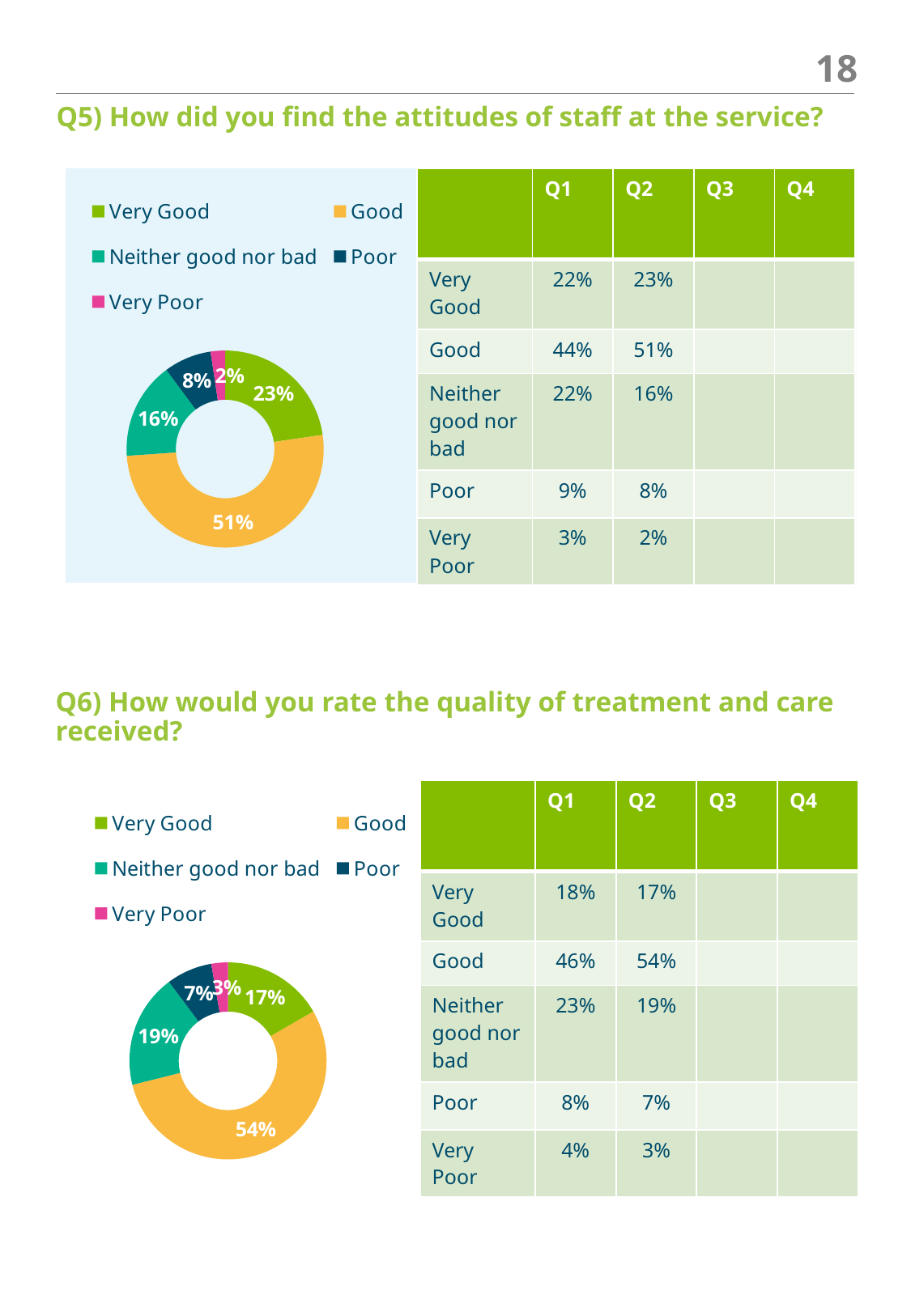
In the top chart (Q5, attitudes of staff), what is the difference between the Very Good and Poor percentages? 15% What type of chart is used for Q5 (top chart)? Doughnut chart In the bottom chart (Q6, quality of treatment and care), what percentage is shown for Very Good? 17% In the bottom chart (Q6, quality of treatment and care), which is larger, Neither good nor bad or Very Good? Neither good nor bad In the top chart (Q5, attitudes of staff), what percentage is shown for Good? 51% In the bottom chart (Q6, quality of treatment and care), what is the difference between the Good and Neither good nor bad percentages? 35% In the bottom chart (Q6, quality of treatment and care), which colour represents Very Poor in the legend? Pink In the top chart (Q5, attitudes of staff), what percentage is shown for Neither good nor bad? 16% In the top chart (Q5, attitudes of staff), which category has the smallest slice? Very Poor In the top chart (Q5, attitudes of staff), how many categories does the legend list? 5 In the top chart (Q5, attitudes of staff), which category has the largest slice? Good In the bottom chart (Q6, quality of treatment and care), what percentage is shown for Poor? 7%